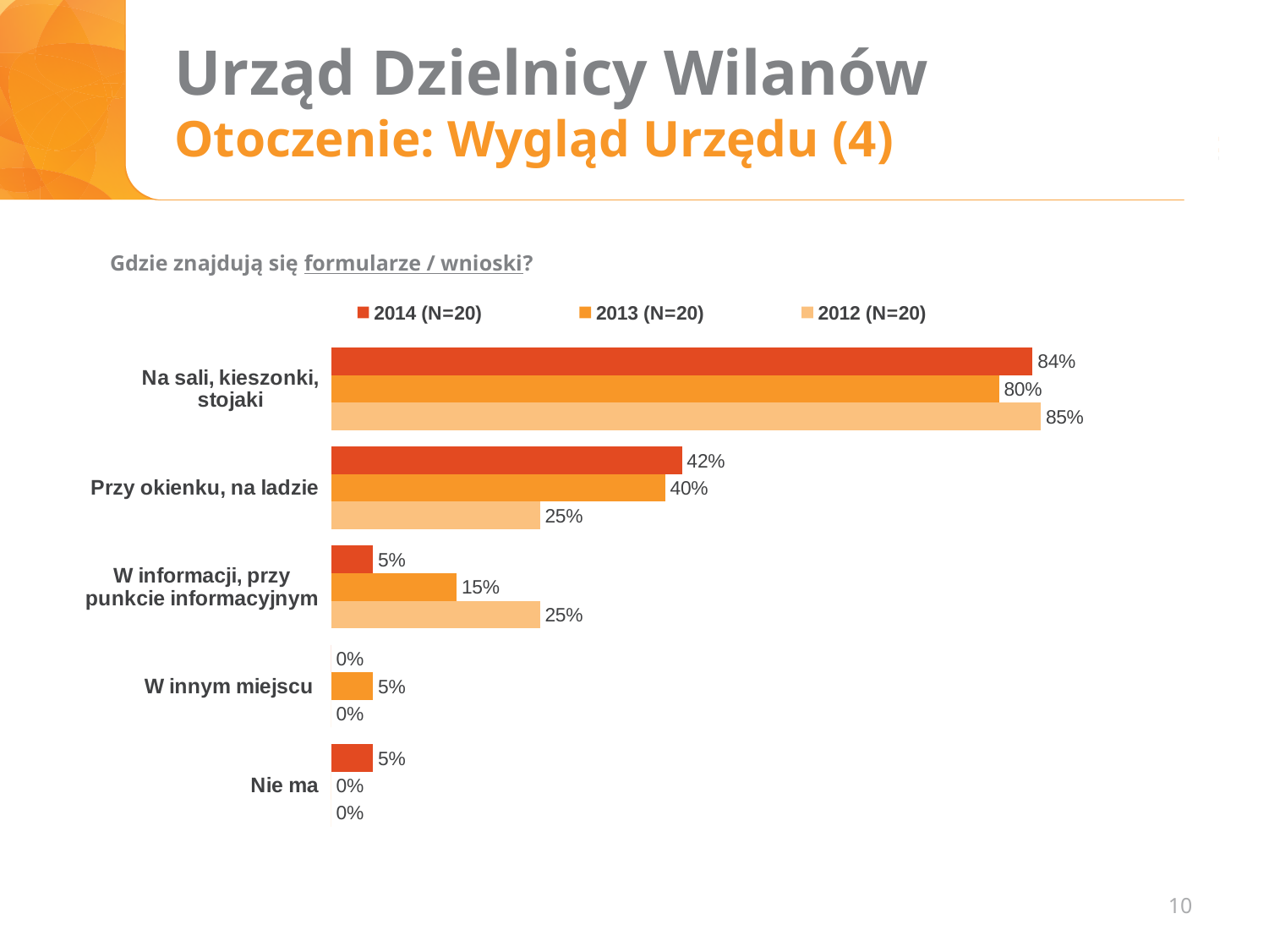
Which is larger for 'W informacji, przy punkcie informacyjnym': the 2014 (N=20) value or the 2012 (N=20) value? 2012 (N=20) How many categories are shown on the chart? 5 What question does the chart answer, according to the text above it? Gdzie znajdują się formularze / wnioski? What is the difference between the 2012 (N=20) and 2013 (N=20) values for 'Na sali, kieszonki, stojaki'? 5% What is the value for 'Na sali, kieszonki, stojaki' in the 2014 (N=20) series? 84% What is the difference between the 2014 (N=20) and 2012 (N=20) values for 'Przy okienku, na ladzie'? 17% How many series does the legend list? 3 Which category has the highest value in the 2013 (N=20) series? Na sali, kieszonki, stojaki What is the value for 'Przy okienku, na ladzie' in the 2012 (N=20) series? 25% What is the value for 'W informacji, przy punkcie informacyjnym' in the 2013 (N=20) series? 15% What is the value for 'Nie ma' in the 2014 (N=20) series? 5% What kind of chart is shown on the slide? Bar chart